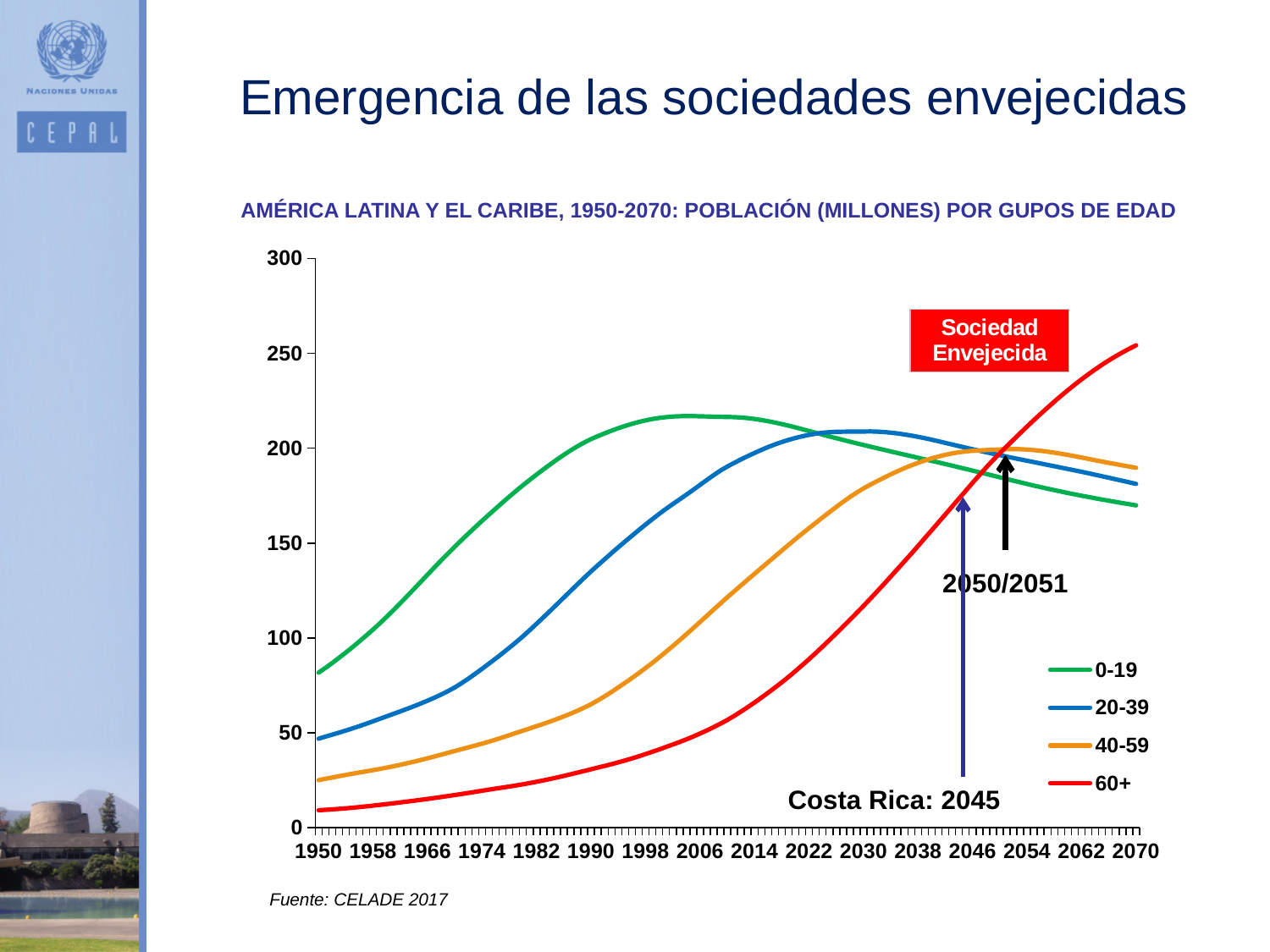
Which age group has the highest population in 2070? 60+ Is the value for the 60+ group in 2070 greater or less than 200? greater How many series does the legend list? 4 What kind of chart is shown on the slide? line chart What year is annotated for Costa Rica on the chart? 2045 Which age group has the highest population in 1950? 0-19 In 2070, which is larger: the 0-19 group or the 60+ group? 60+ Does the 60+ line rise or fall from 1950 to 2070? rises Which age groups are listed in the chart legend? 0-19, 20-39, 40-59, 60+ Is the value for the 0-19 group in 1950 greater or less than 100? less Is the value for the 40-59 group in 1950 greater or less than 50? less Which age group has the lowest population in 1950? 60+